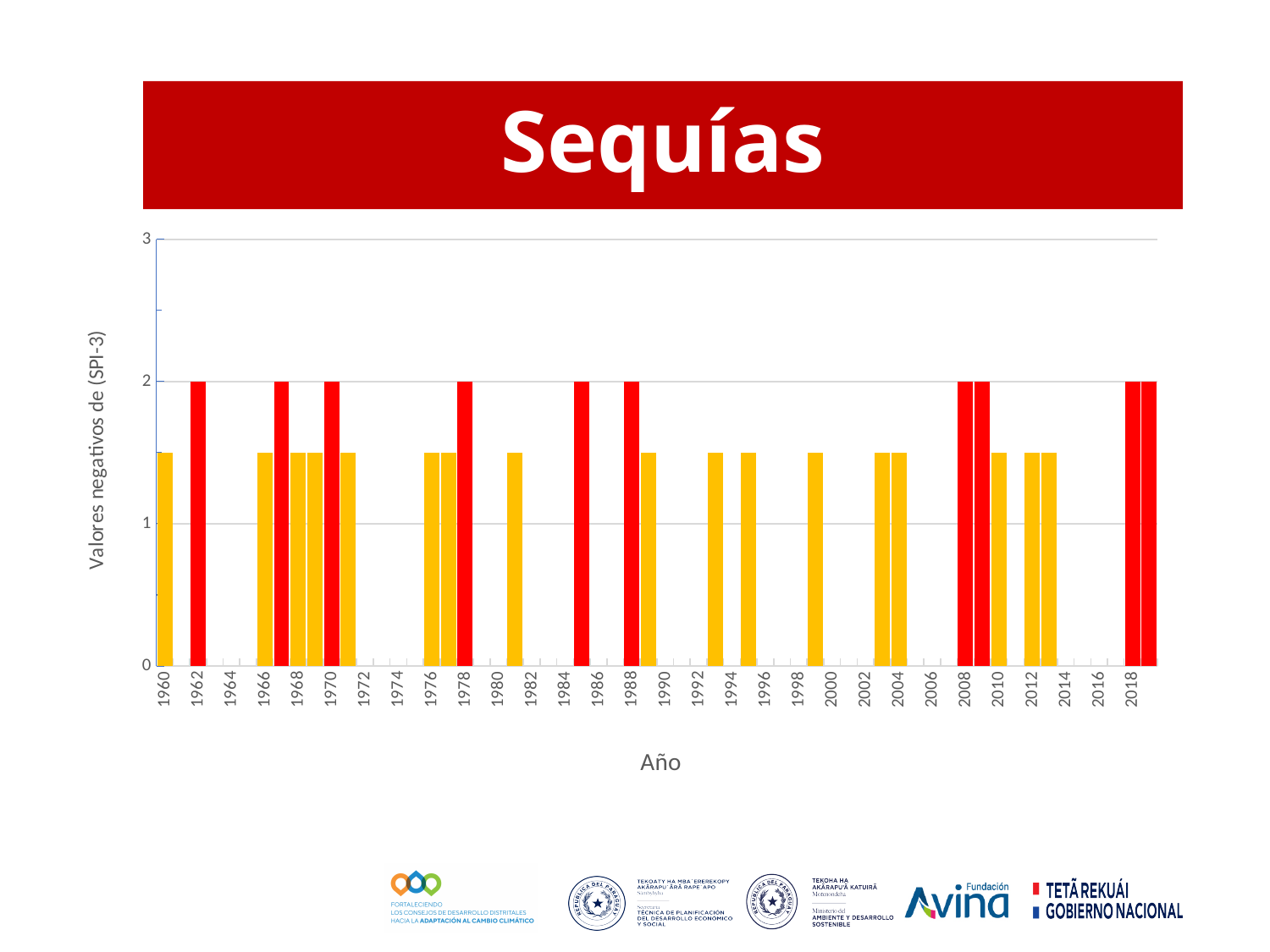
Which is larger, the value for 1960 or the value for 1962? 1962 What is the value for 2008? 2 Is the value for 1960 greater or less than 1? greater What is the label of the x axis? Año What is the value for 1962? 2 What is the highest value shown on the y axis? 3 What is the value for 1978? 2 What is the title of the chart on the slide? Sequías Is the value for 1960 greater or less than 2? less What is the value for 2018? 2 Which is larger, the value for 1988 or the value for 1989? 1988 What kind of chart is shown on the slide? bar chart